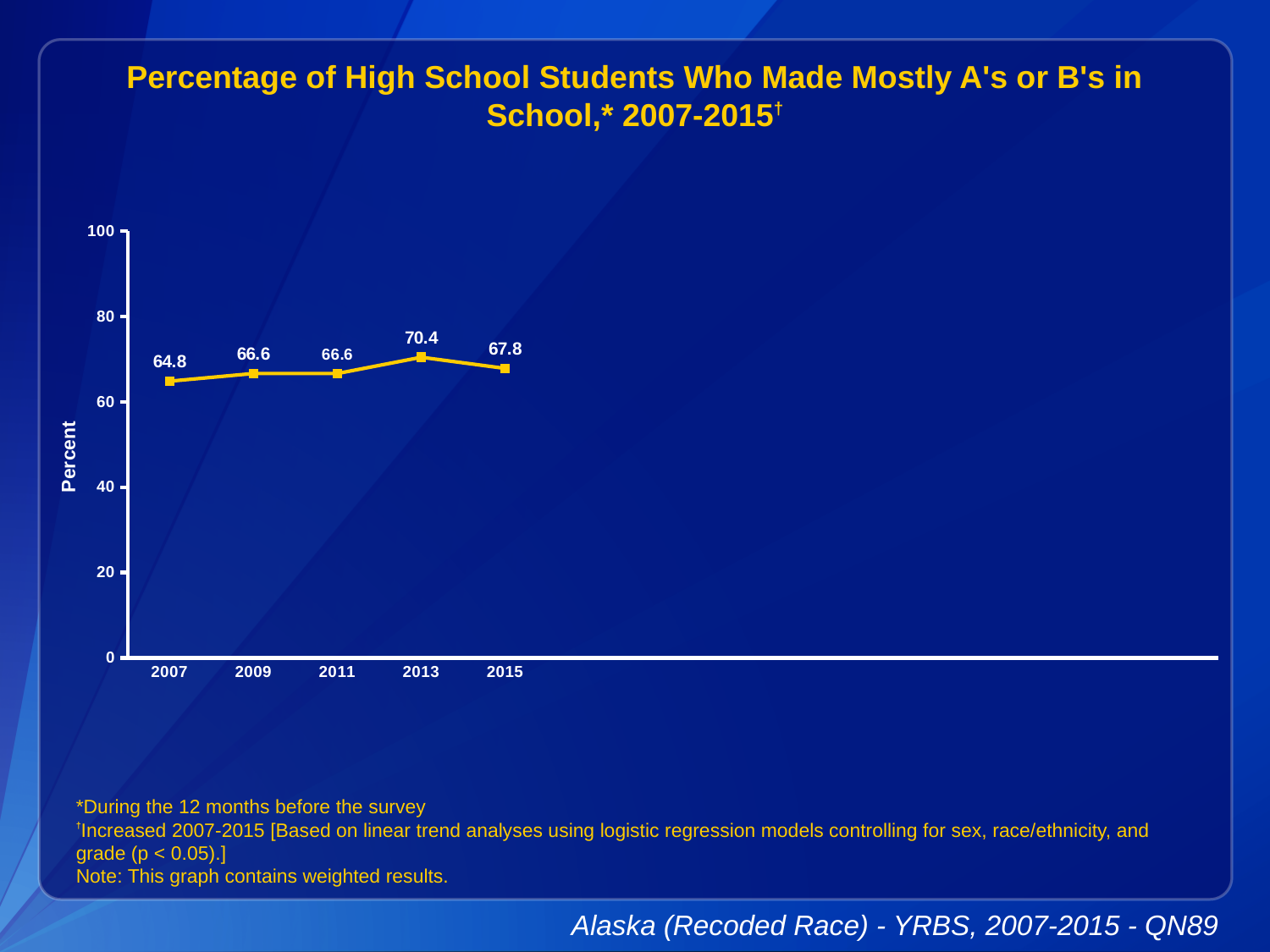
What is the difference between the 2013 value and the 2007 value? 5.6 Which year has the highest percentage of students who made mostly A's or B's? 2013 What is the value plotted for 2013? 70.4 Did the percentage rise or fall from 2007 to 2013? rise Is the value for 2013 greater or less than 80? less Which year has the lowest percentage of students who made mostly A's or B's? 2007 Which year has a larger value, 2015 or 2011? 2015 What percentage of high school students made mostly A's or B's in school in 2007? 64.8 How many years are plotted on the chart? 5 What is the label on the vertical axis of the chart? Percent What kind of chart is shown on the slide? line chart What is the value plotted for 2015? 67.8